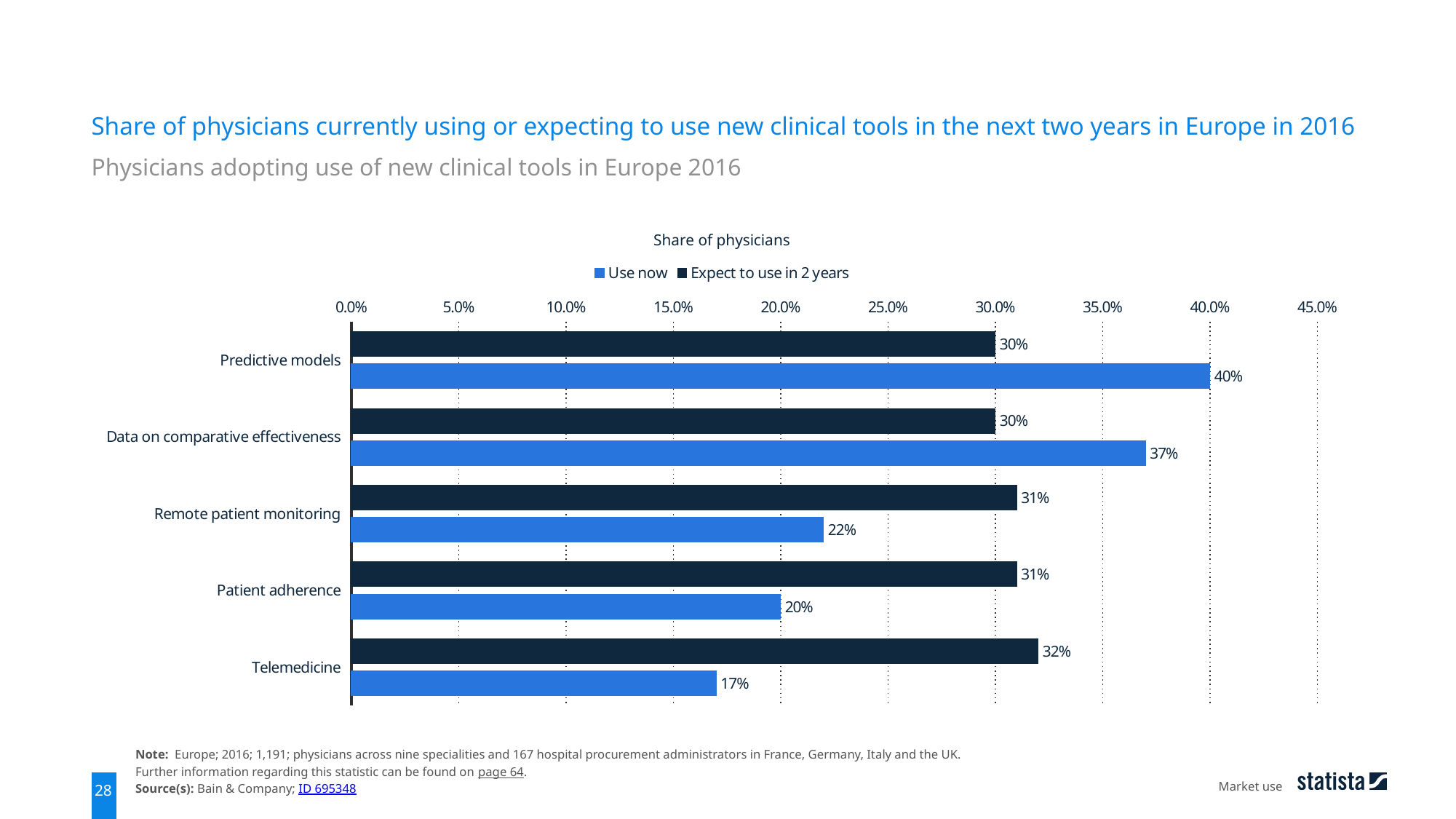
What kind of chart is shown on the slide? Bar chart Which clinical tool has the lowest 'Use now' share? Telemedicine What is the difference between the 'Use now' and 'Expect to use in 2 years' values for patient adherence? 11% Which clinical tool has the highest 'Use now' share? Predictive models How many clinical tools (categories) are shown in the chart? 5 What is the 'Use now' value for remote patient monitoring? 22% Which colour represents the 'Expect to use in 2 years' series? Dark navy How many series does the legend list? 2 What share of physicians currently use predictive models (Use now)? 40% Is the 'Use now' value for telemedicine greater or less than 20.0%? less For data on comparative effectiveness, which is larger: the 'Use now' share or the 'Expect to use in 2 years' share? Use now What share of physicians expect to use telemedicine in 2 years? 32%